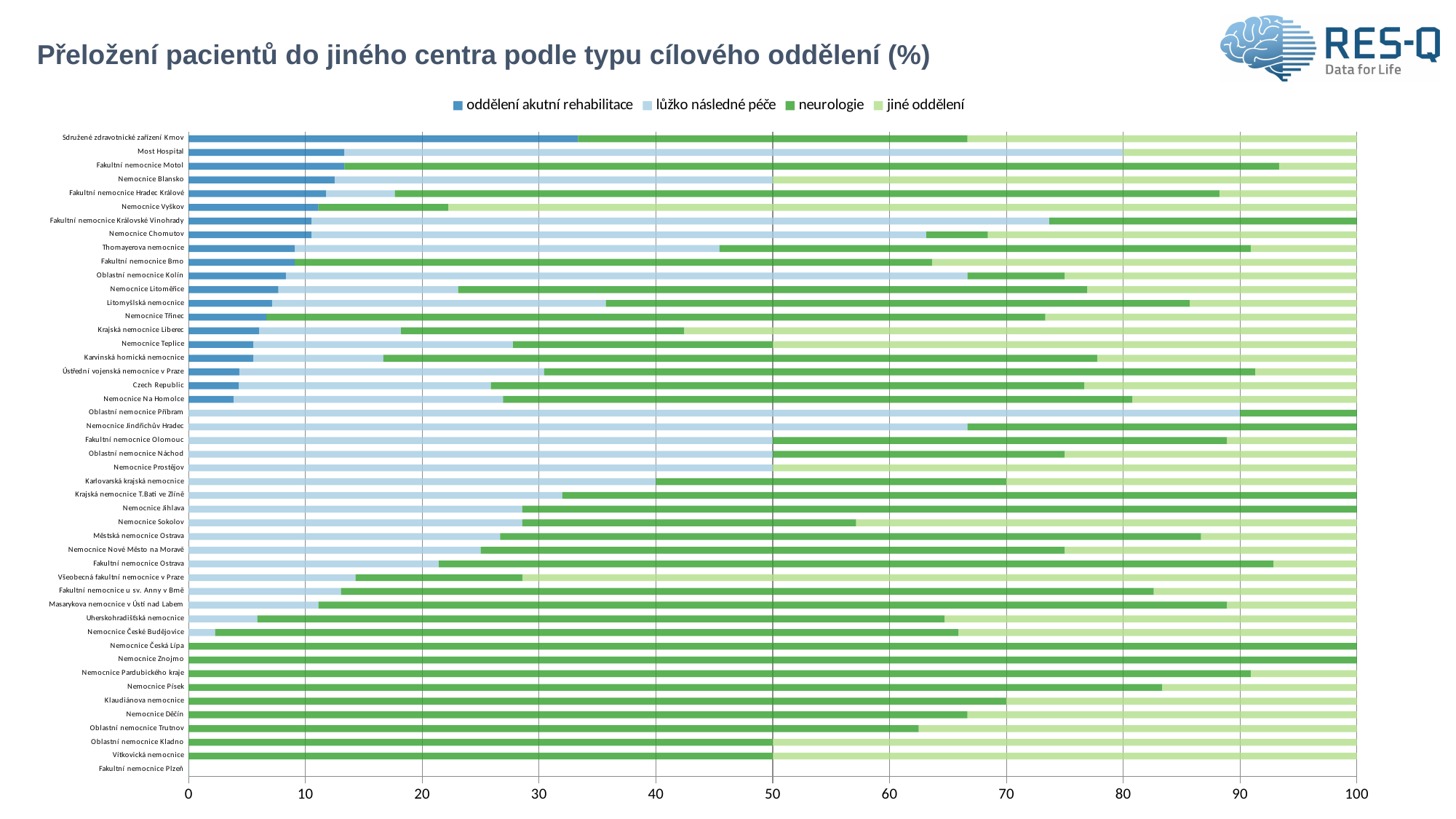
What is the title of the chart? Přeložení pacientů do jiného centra podle typu cílového oddělení (%) What is the value of lůžko následné péče for Fakultní nemocnice Olomouc? 50 What kind of chart is shown on the slide? bar chart Which hospital has the highest value for lůžko následné péče? Oblastní nemocnice Příbram Which series is shown in dark blue in the legend? oddělení akutní rehabilitace What is the value of neurologie for Oblastní nemocnice Kladno? 50 Which hospital has the highest value for oddělení akutní rehabilitace? Sdružené zdravotnické zařízení Krnov How many series does the legend list? 4 Is the value of oddělení akutní rehabilitace for Sdružené zdravotnické zařízení Krnov greater or less than 30? greater Is the value of oddělení akutní rehabilitace for Most Hospital greater or less than 20? less What is the value of lůžko následné péče for Nemocnice Prostějov? 50 Which is larger: the oddělení akutní rehabilitace value for Sdružené zdravotnické zařízení Krnov or for Fakultní nemocnice Motol? Sdružené zdravotnické zařízení Krnov